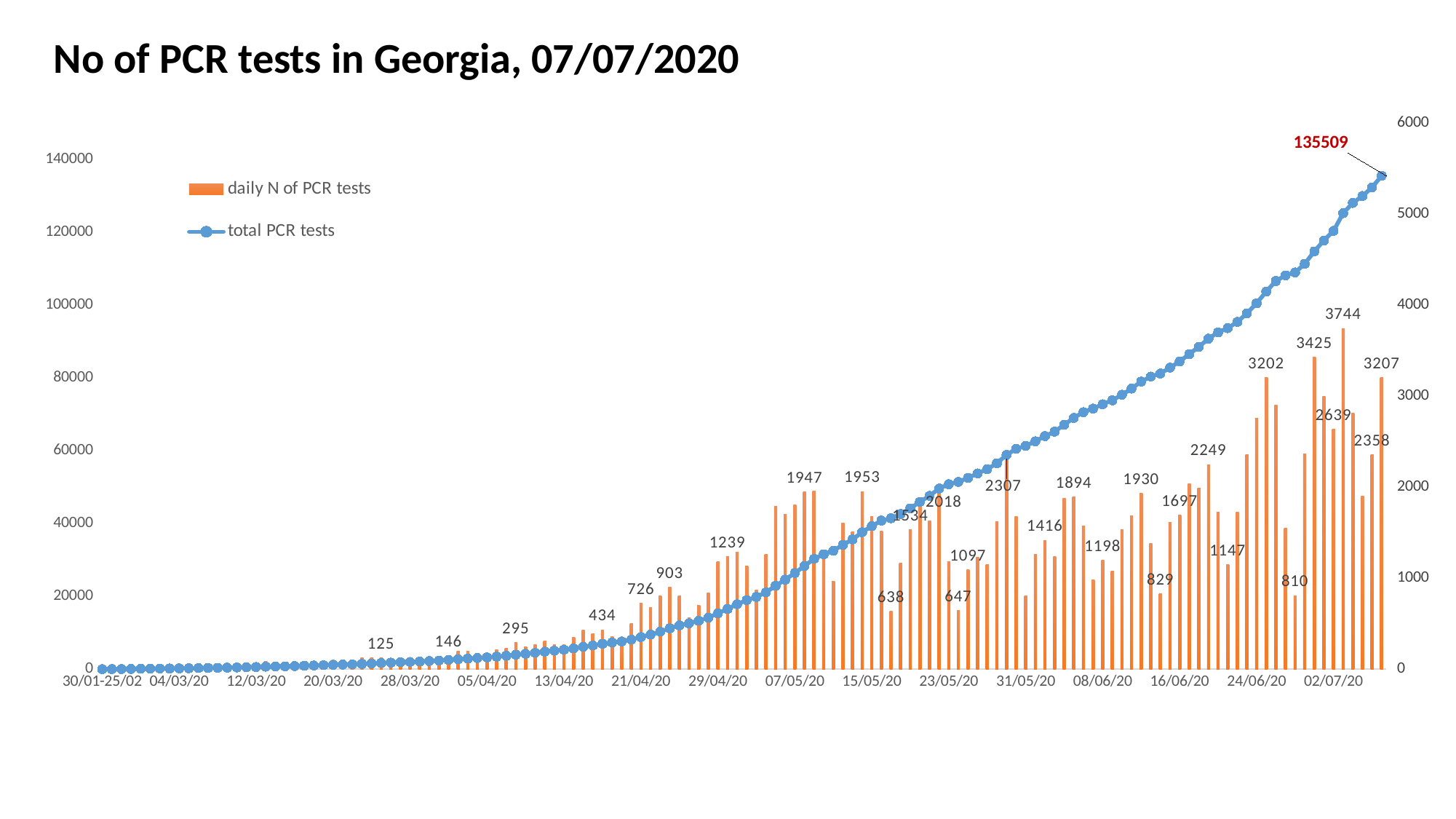
Does the total PCR tests line rise or fall over time along the x axis? Rises What is the highest labelled daily number of PCR tests on the chart? 3744 Is the total PCR tests value at 07/05/20 greater or less than 40000? less What kind of chart is shown on the slide? A combined bar and line chart Which series is shown as orange bars according to the legend? daily N of PCR tests What is the difference between the labelled daily values 3744 and 3425? 319 What is the title of the chart? No of PCR tests in Georgia, 07/07/2020 Is the total PCR tests value at 24/06/20 greater or less than 80000? greater What is the lowest labelled daily number of PCR tests on the chart? 125 How many series does the legend list? 2 Which labelled daily value is larger, 3202 or 3425? 3425 What is the final value shown for total PCR tests on the chart? 135509